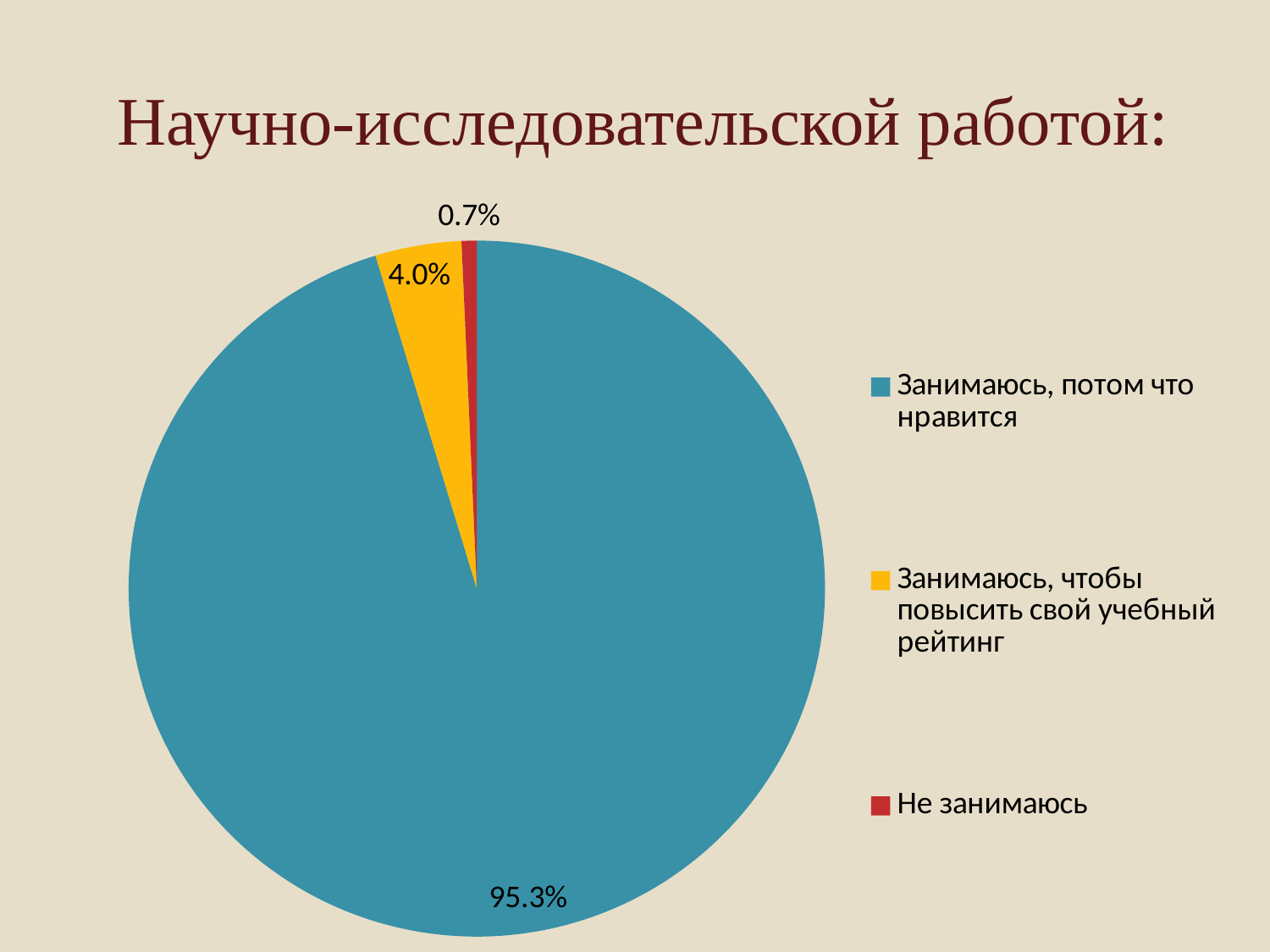
How many entries does the legend list? 3 Which category has the smallest slice of the pie? Не занимаюсь What kind of chart is shown on the slide? pie chart Which is larger: the "Занимаюсь, чтобы повысить свой учебный рейтинг" slice or the "Не занимаюсь" slice? Занимаюсь, чтобы повысить свой учебный рейтинг What share of the pie is labelled "Не занимаюсь"? 0.7% Which category has the largest slice of the pie? Занимаюсь, потом что нравится What colour is the slice for "Не занимаюсь"? red How many slices does the pie chart have? 3 What share of the pie is labelled "Занимаюсь, потом что нравится"? 95.3% What is the title of the slide? Научно-исследовательской работой: What is the difference in percentage points between the "Занимаюсь, чтобы повысить свой учебный рейтинг" slice and the "Не занимаюсь" slice? 3.3% What share of the pie is labelled "Занимаюсь, чтобы повысить свой учебный рейтинг"? 4.0%